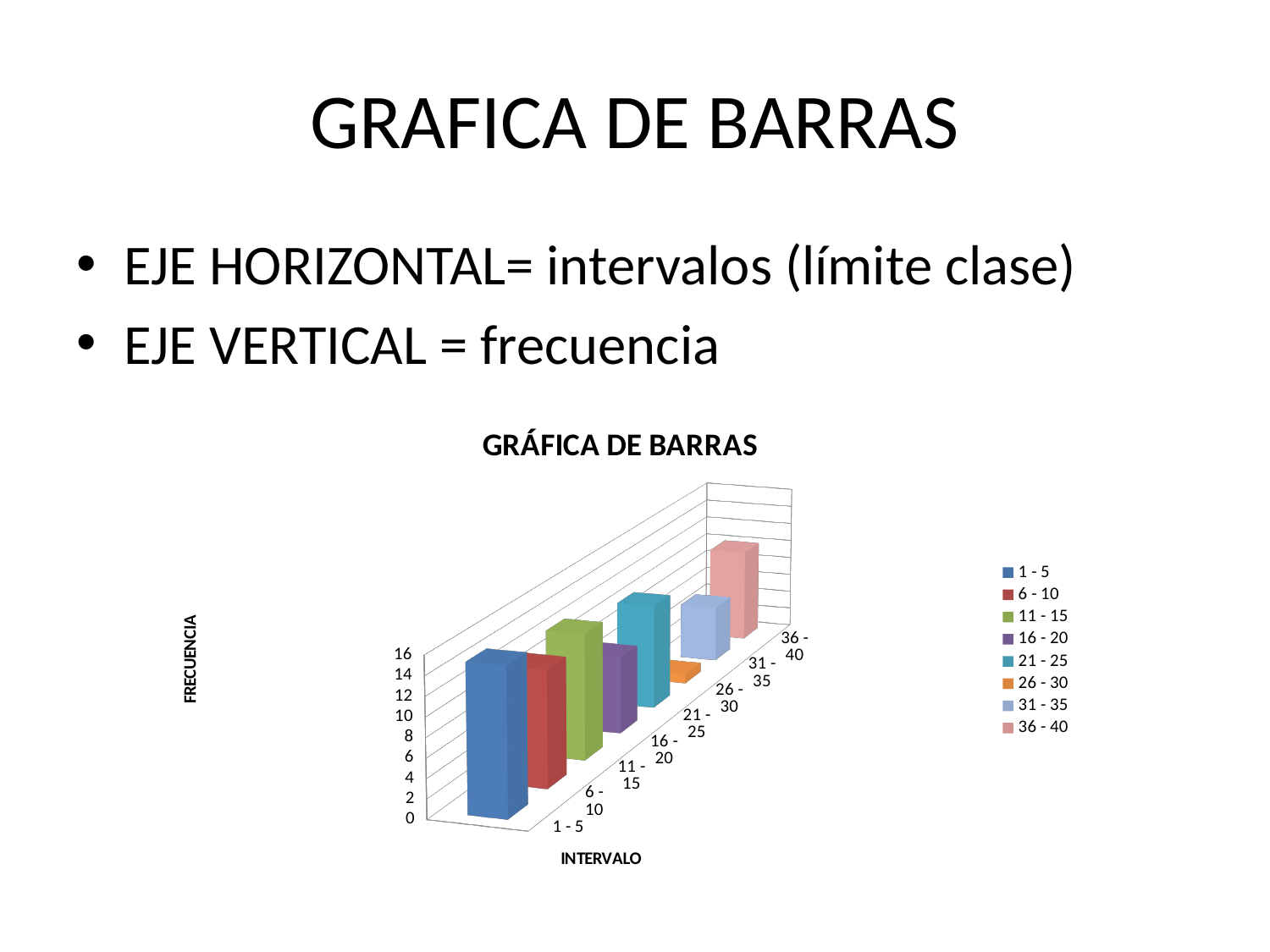
Is the frequency for the interval 1 - 5 greater or less than 10? greater Which has the larger frequency, the interval 36 - 40 or the interval 26 - 30? 36 - 40 Which has the larger frequency, the interval 1 - 5 or the interval 26 - 30? 1 - 5 What is the title of the chart? GRÁFICA DE BARRAS What is the label of the vertical axis of the chart? FRECUENCIA Which interval has the lowest frequency in the chart? 26 - 30 Is the frequency for the interval 26 - 30 greater or less than 4? less How many entries does the chart legend list? 8 How many intervals (categories) are plotted on the chart? 8 What kind of chart is shown on the slide? bar chart